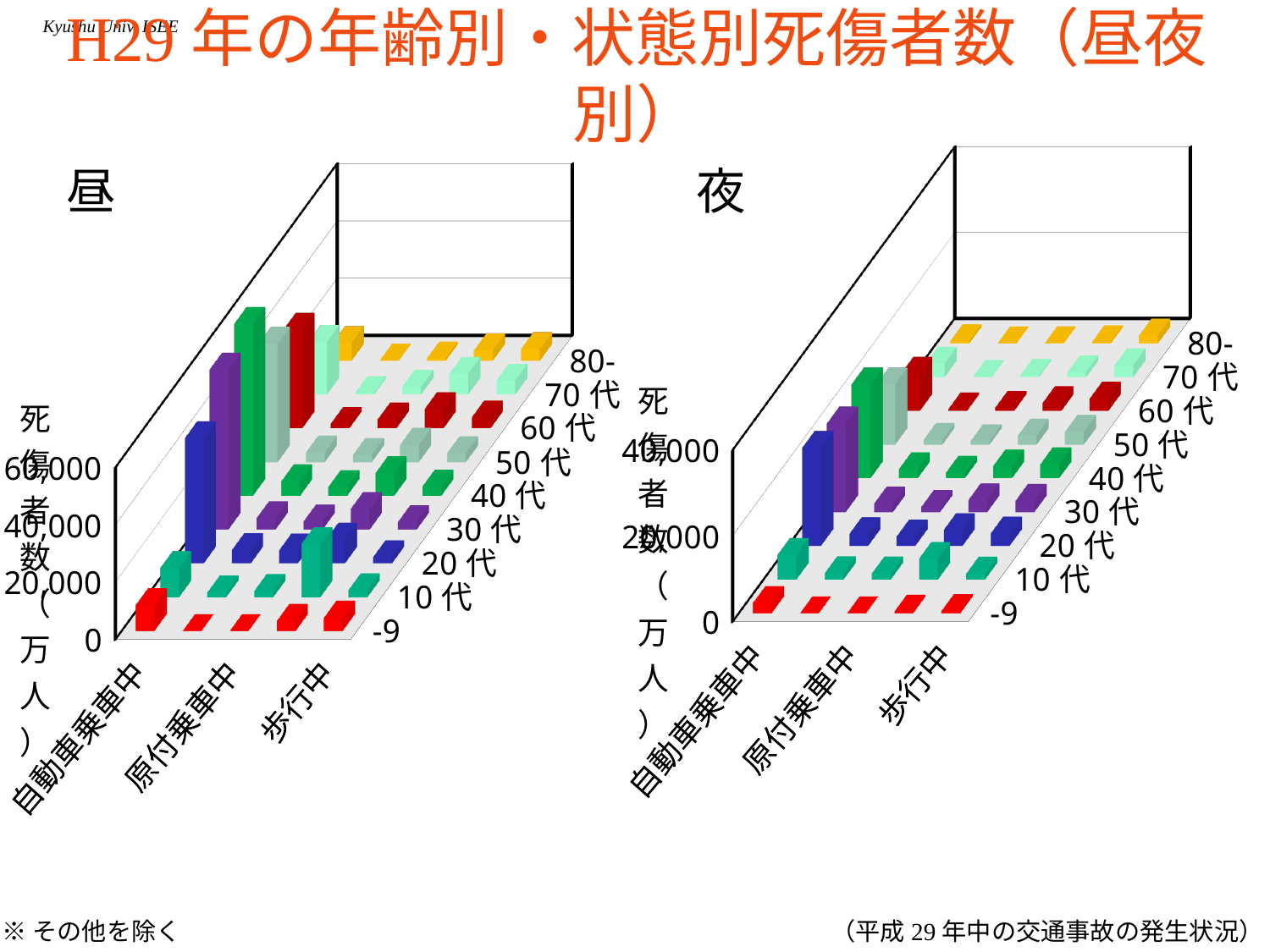
In the 夜 chart, which category has the tallest bars overall? 自動車乗車中 In the 昼 chart, which category has the tallest bars overall? 自動車乗車中 In the 夜 chart, is the value for 原付乗車中 in the 80- age group greater or less than 20,000? less In the 昼 chart, is the value for 自動車乗車中 in the 40代 age group greater or less than 40,000? greater In the 昼 chart, which is larger for the 20代 age group: 自動車乗車中 or 原付乗車中? 自動車乗車中 What kind of chart is used for the 昼 (day) chart on the left? 3D bar chart What is the title of the slide containing the two charts? H29 年の年齢別・状態別死傷者数（昼夜別） In the 昼 chart, which is larger for 歩行中: the 10代 age group or the -9 age group? -9 How many age groups are plotted along the depth axis of the 夜 chart? 9 What is the highest tick value shown on the vertical axis of the 昼 chart? 60,000